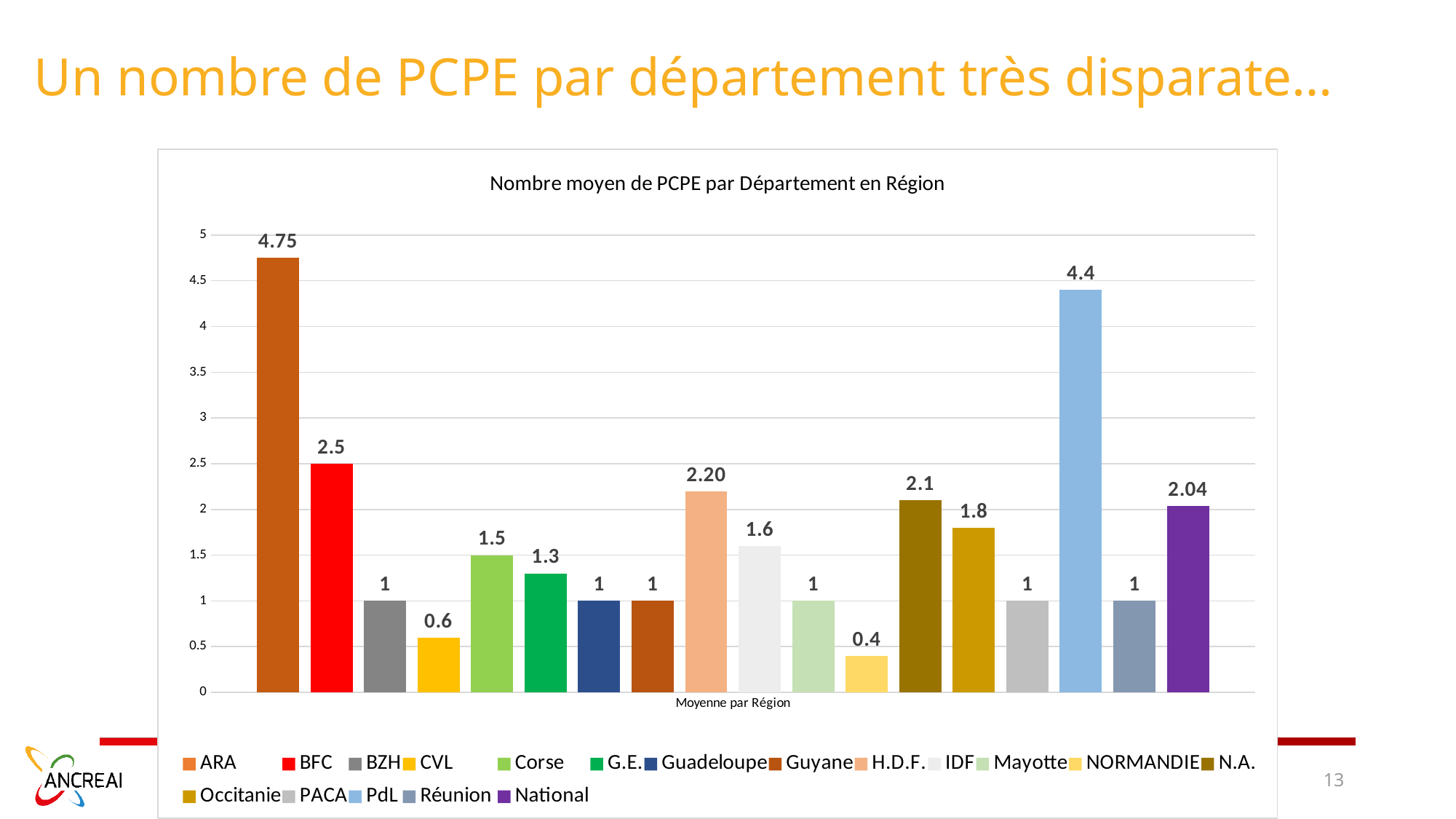
How many bars are plotted in the chart? 18 Which region has the lowest value? NORMANDIE How many entries does the legend list? 18 Which region has the highest value? ARA What is the value for ARA? 4.75 Is the value for Occitanie greater or less than 2? less Which is larger, the value for BFC or the value for N.A.? BFC What is the value for PdL? 4.4 What is the value for H.D.F.? 2.20 What is the title of the chart? Nombre moyen de PCPE par Département en Région What is the difference between the values for ARA and PdL? 0.35 What is the value for National? 2.04